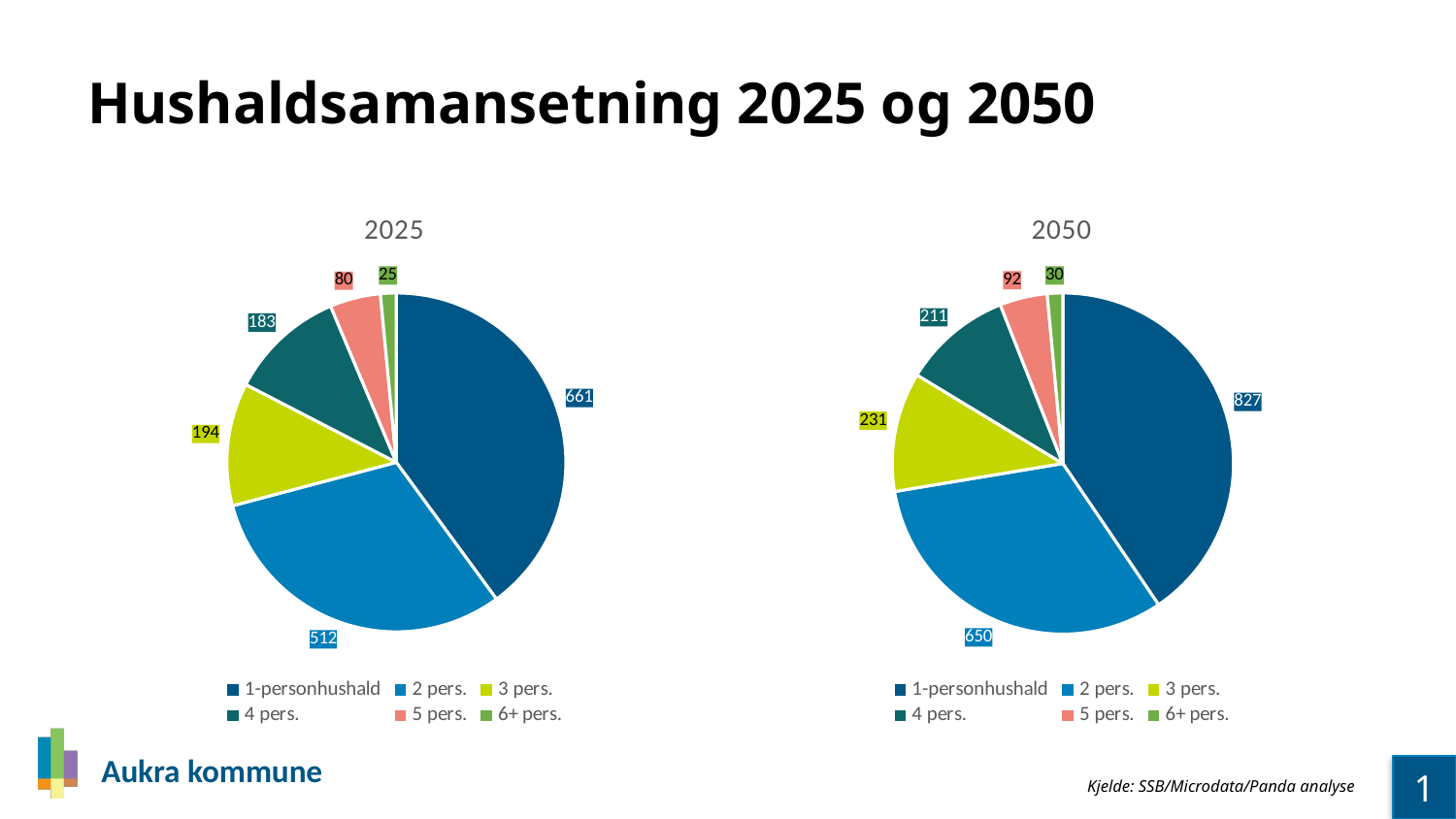
What is the title of the slide? Hushaldsamansetning 2025 og 2050 How many slices does the 2025 pie chart have? 6 In the 2025 pie chart, what is the difference between the values for 3 pers. and 4 pers.? 11 Is the value for 5 pers. larger in the 2025 chart or the 2050 chart? 2050 What type of chart is used to show the 2050 data? Pie chart In the 2050 pie chart, what is the difference between the values for 1-personhushald and 2 pers.? 177 In the 2025 pie chart, what is the value for 1-personhushald? 661 In the 2050 pie chart, what is the value for 2 pers.? 650 What is the total of all slices in the 2050 pie chart? 2041 In the 2025 pie chart, what is the value for 4 pers.? 183 In the 2050 pie chart, which category has the smallest slice? 6+ pers. In the 2025 pie chart, which category has the largest slice? 1-personhushald